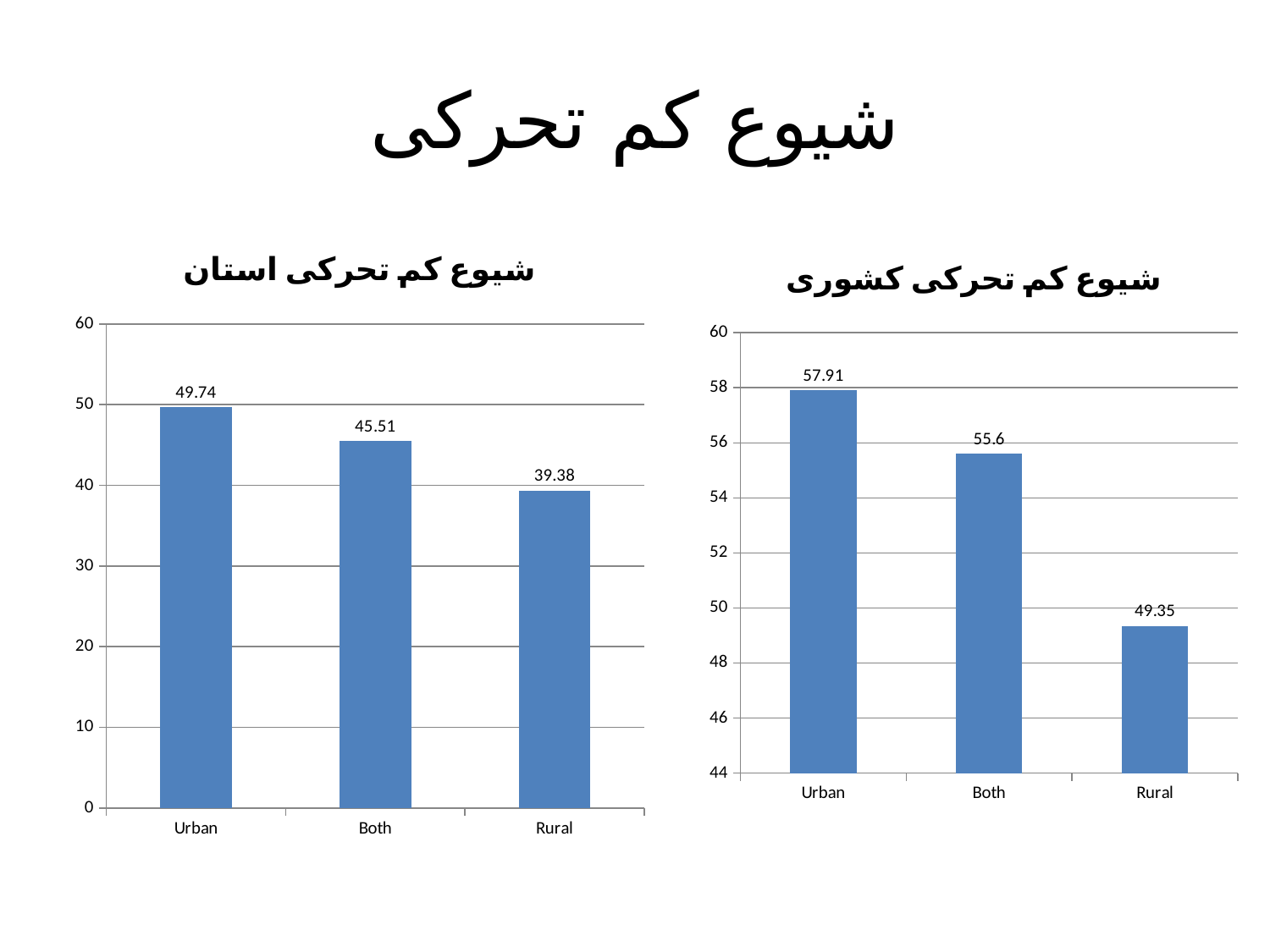
In the right chart (شیوع کم تحرکی کشوری), which category has the highest value? Urban In the left chart (شیوع کم تحرکی استان), which category has the lowest value? Rural In the right chart (شیوع کم تحرکی کشوری), is the value for Rural greater or less than 50? less In the right chart (شیوع کم تحرکی کشوری), what is the value for Rural? 49.35 What kind of chart is the right chart (شیوع کم تحرکی کشوری)? bar chart How many categories are shown on the x axis of the left chart (شیوع کم تحرکی استان)? 3 In the left chart (شیوع کم تحرکی استان), what is the value for Rural? 39.38 In the right chart (شیوع کم تحرکی کشوری), what is the value for Both? 55.6 In the left chart (شیوع کم تحرکی استان), what is the difference between the Urban and Rural values? 10.36 In the left chart (شیوع کم تحرکی استان), what is the value for Urban? 49.74 In the left chart (شیوع کم تحرکی استان), which is larger, the value for Both or the value for Rural? Both In the right chart (شیوع کم تحرکی کشوری), what is the difference between the Urban and Both values? 2.31